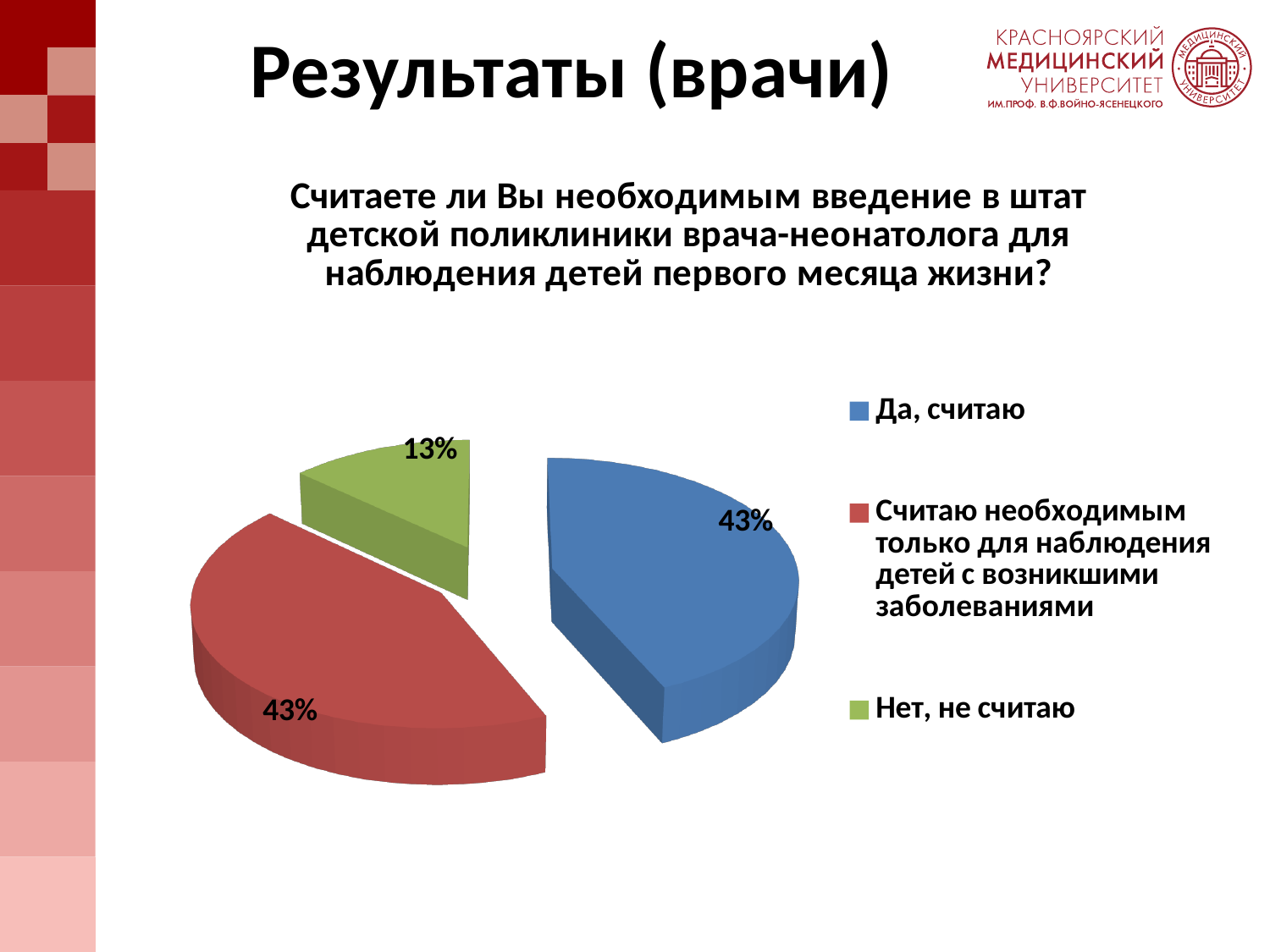
What question is the chart answering, as written above it? Считаете ли Вы необходимым введение в штат детской поликлиники врача-неонатолога для наблюдения детей первого месяца жизни? Which category has the smallest slice of the pie? Нет, не считаю What is the value shown for "Считаю необходимым только для наблюдения детей с возникшими заболеваниями"? 43% What is the value shown for "Нет, не считаю"? 13% What share of the pie does the slice "Да, считаю" represent? 43% Which is larger: the slice for "Да, считаю" or the slice for "Нет, не считаю"? Да, считаю How many entries does the legend list? 3 Which colour represents "Нет, не считаю" in the chart? Green What kind of chart is shown on the slide? Pie chart What is the difference in percentage points between "Да, считаю" and "Нет, не считаю"? 30 percentage points How many slices does the pie chart have? 3